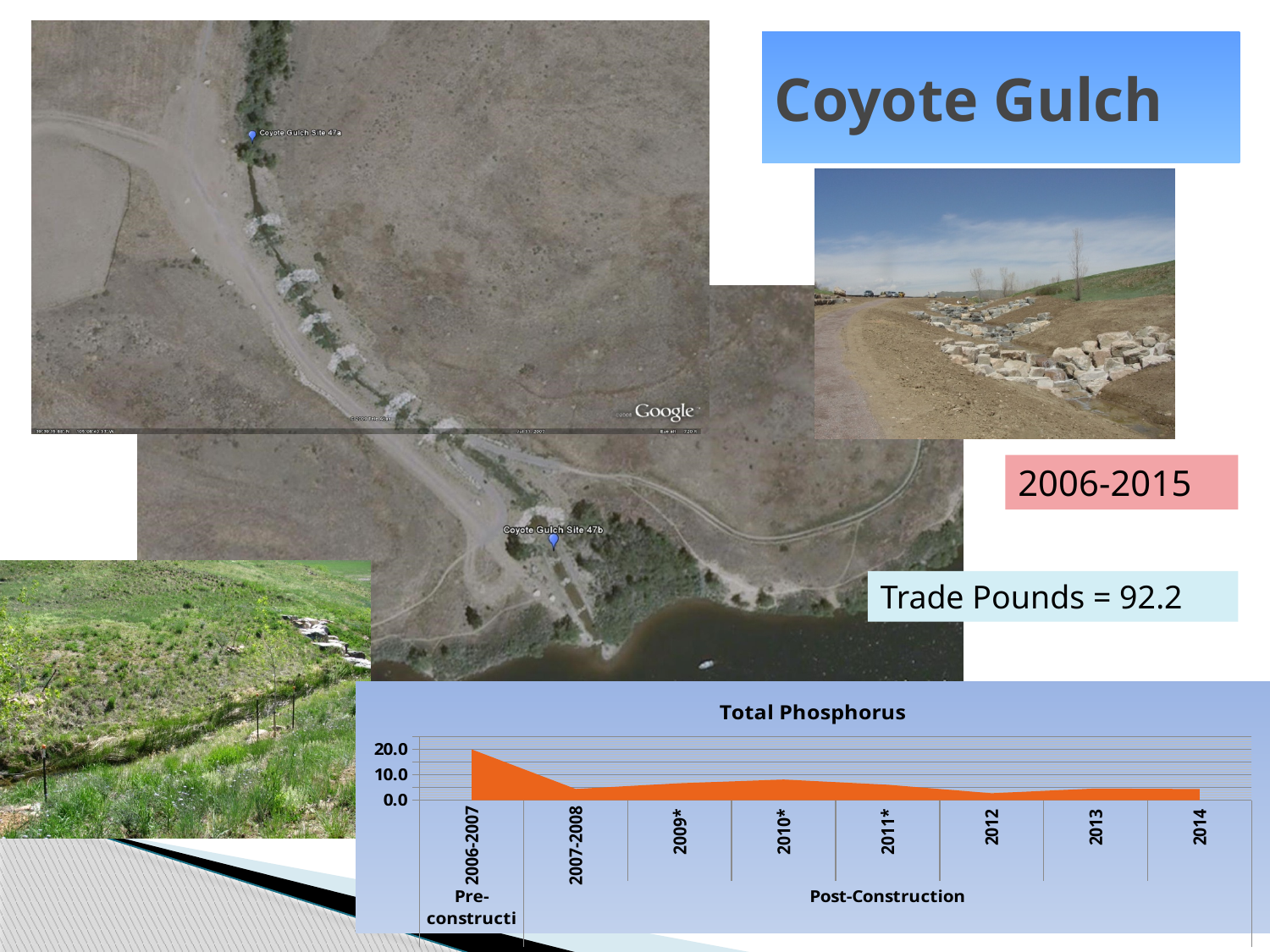
Which category has the highest Total Phosphorus value? 2006-2007 Which category on the chart is labelled as Pre-construction? 2006-2007 Which has a higher Total Phosphorus value, 2010* or 2012? 2010* Is the Total Phosphorus value for 2014 greater or less than 10.0? less Which has a higher Total Phosphorus value, 2006-2007 or 2010*? 2006-2007 How many categories are shown along the x axis of the Total Phosphorus chart? 8 Is the Total Phosphorus value for 2007-2008 greater or less than 10.0? less Is the Total Phosphorus value for 2006-2007 greater or less than 10.0? greater What is the title of the chart? Total Phosphorus What kind of chart is shown on the slide? area chart Do Total Phosphorus values generally rise or fall from 2006-2007 to 2014? fall